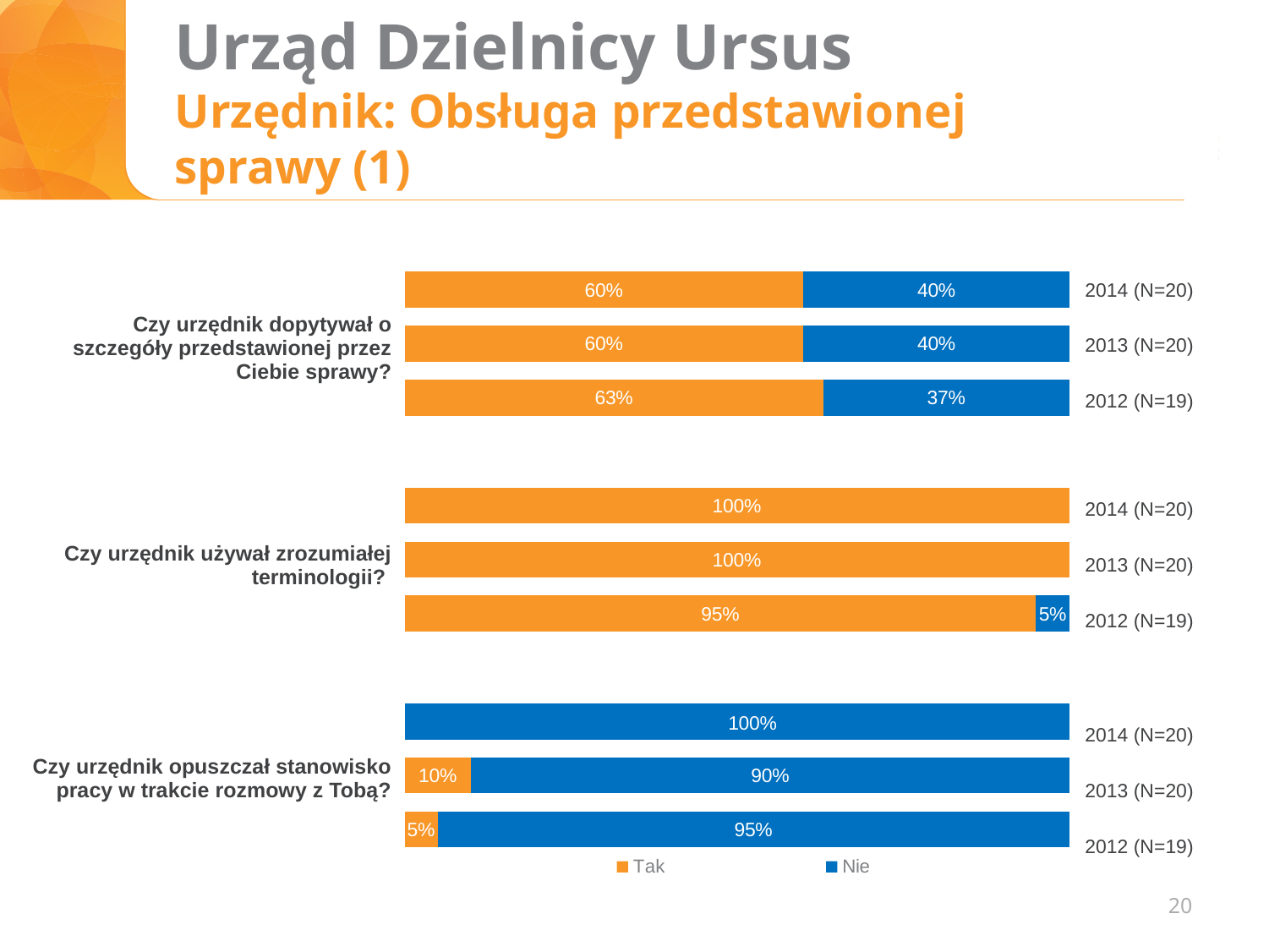
In the chart for "Czy urzędnik używał zrozumiałej terminologii?", what is the "Nie" value for 2012 (N=19)? 5% In the chart for "Czy urzędnik dopytywał o szczegóły przedstawionej przez Ciebie sprawy?", which year has the highest "Tak" value? 2012 (N=19) In the chart for "Czy urzędnik dopytywał o szczegóły przedstawionej przez Ciebie sprawy?", what is the "Tak" value for 2012 (N=19)? 63% In the chart for "Czy urzędnik opuszczał stanowisko pracy w trakcie rozmowy z Tobą?", what is the "Nie" value for 2014 (N=20)? 100% In the chart for "Czy urzędnik opuszczał stanowisko pracy w trakcie rozmowy z Tobą?", what is the "Tak" value for 2013 (N=20)? 10% Which colour represents "Nie" in the legend? Blue In the chart for "Czy urzędnik opuszczał stanowisko pracy w trakcie rozmowy z Tobą?", which year has the lowest "Nie" value? 2013 (N=20) In the chart for "Czy urzędnik opuszczał stanowisko pracy w trakcie rozmowy z Tobą?", is the "Tak" value for 2013 (N=20) larger or smaller than the "Tak" value for 2012 (N=19)? larger How many series does the legend list? 2 In the chart for "Czy urzędnik dopytywał o szczegóły przedstawionej przez Ciebie sprawy?", what is the "Nie" value for 2014 (N=20)? 40% What kind of chart is shown on the slide? Stacked bar chart In the chart for "Czy urzędnik dopytywał o szczegóły przedstawionej przez Ciebie sprawy?", what is the difference between the "Tak" and "Nie" values for 2012 (N=19)? 26%